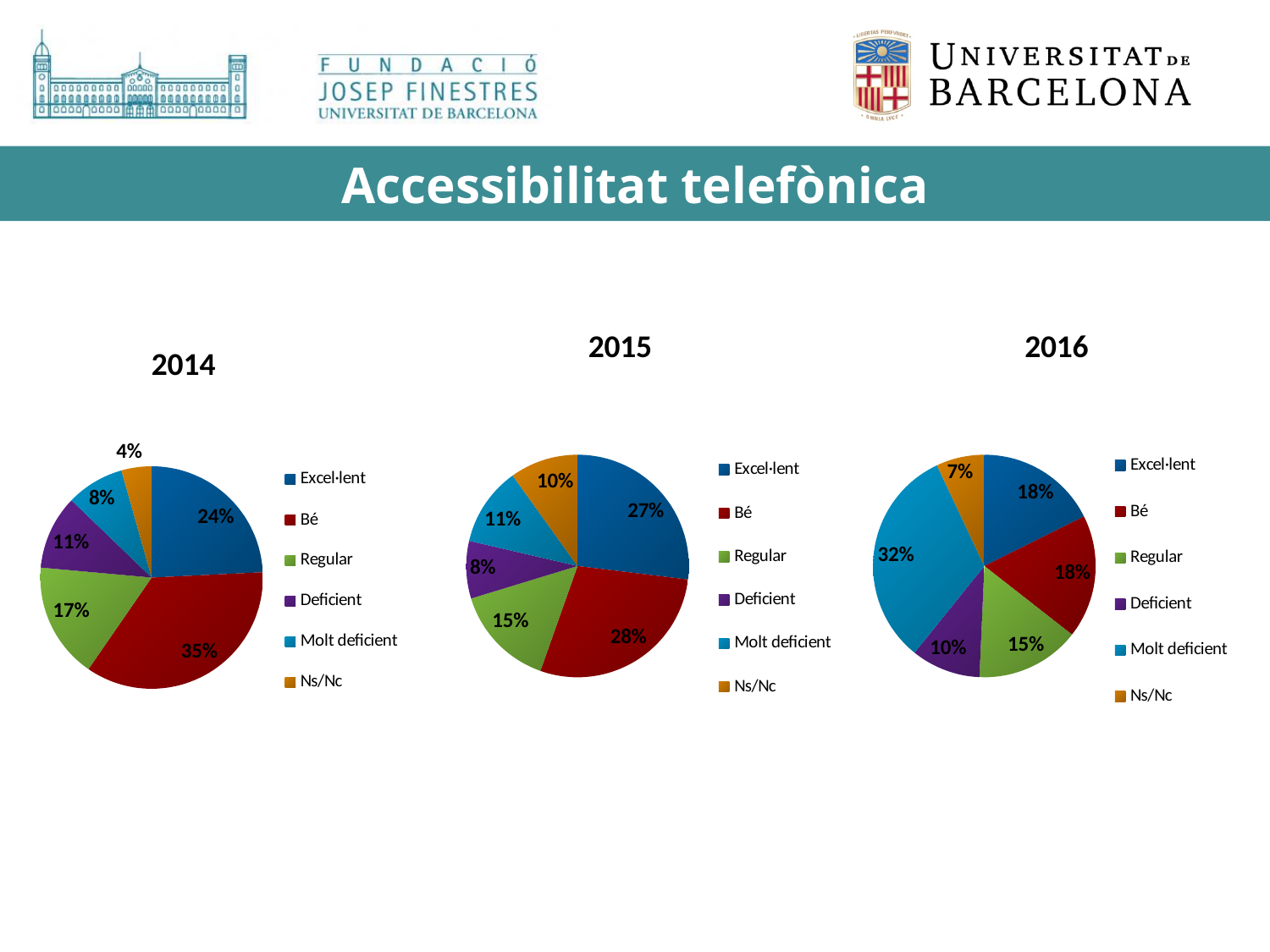
In the 2014 chart, what is the difference between the Bé and Excel·lent shares? 11% In the 2015 chart, what is the difference between the Regular and Deficient shares? 7% In the 2016 chart, what share does the Molt deficient slice have? 32% In the 2016 chart, which is larger, Regular or Deficient? Regular How many slices does the 2016 pie chart have? 6 In the 2015 chart, which category has the smallest slice? Deficient What type of chart is used for the 2015 data? Pie chart In the 2014 chart, which category has the smallest slice? Ns/Nc In the 2014 chart, what share does the Bé slice have? 35% How many pie charts are shown on the slide? 3 In the 2016 chart, which category has the largest slice? Molt deficient In the 2015 chart, what share does the Excel·lent slice have? 27%